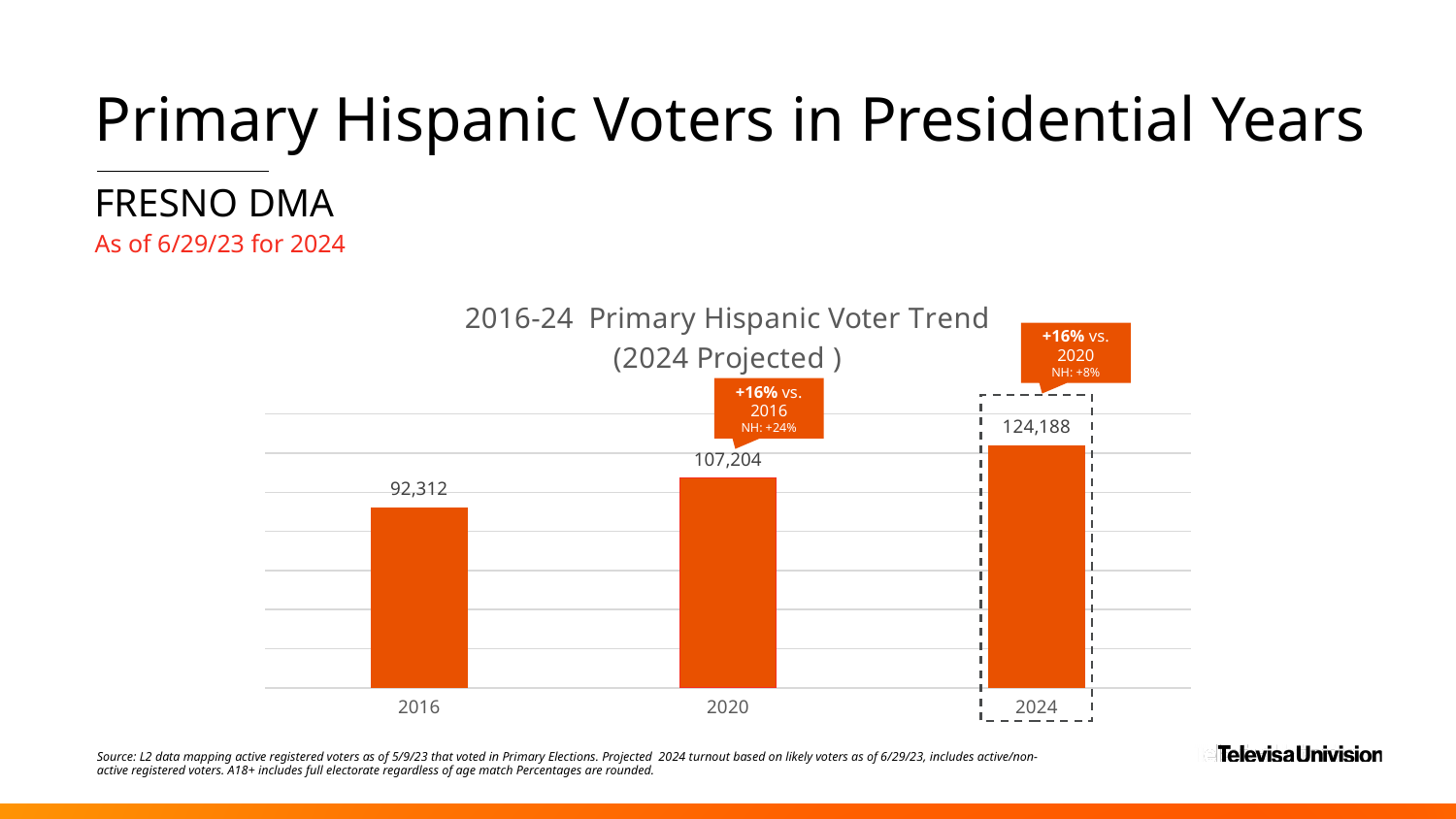
What is the value for 2020 in the chart? 107,204 What is the value for 2016 in the chart? 92,312 What is the title of the chart? 2016-24 Primary Hispanic Voter Trend (2024 Projected) Do the values rise or fall from 2016 to 2024? Rise What kind of chart is shown on the slide? Bar chart What is the projected value for 2024 in the chart? 124,188 What is the difference between the 2020 and 2016 values? 14,892 Which year has the lowest value in the chart? 2016 What is the difference between the 2024 and 2020 values? 16,984 Which year has the highest value in the chart? 2024 How many years are shown as bars in the chart? 3 Which is larger, the value for 2020 or the value for 2024? 2024